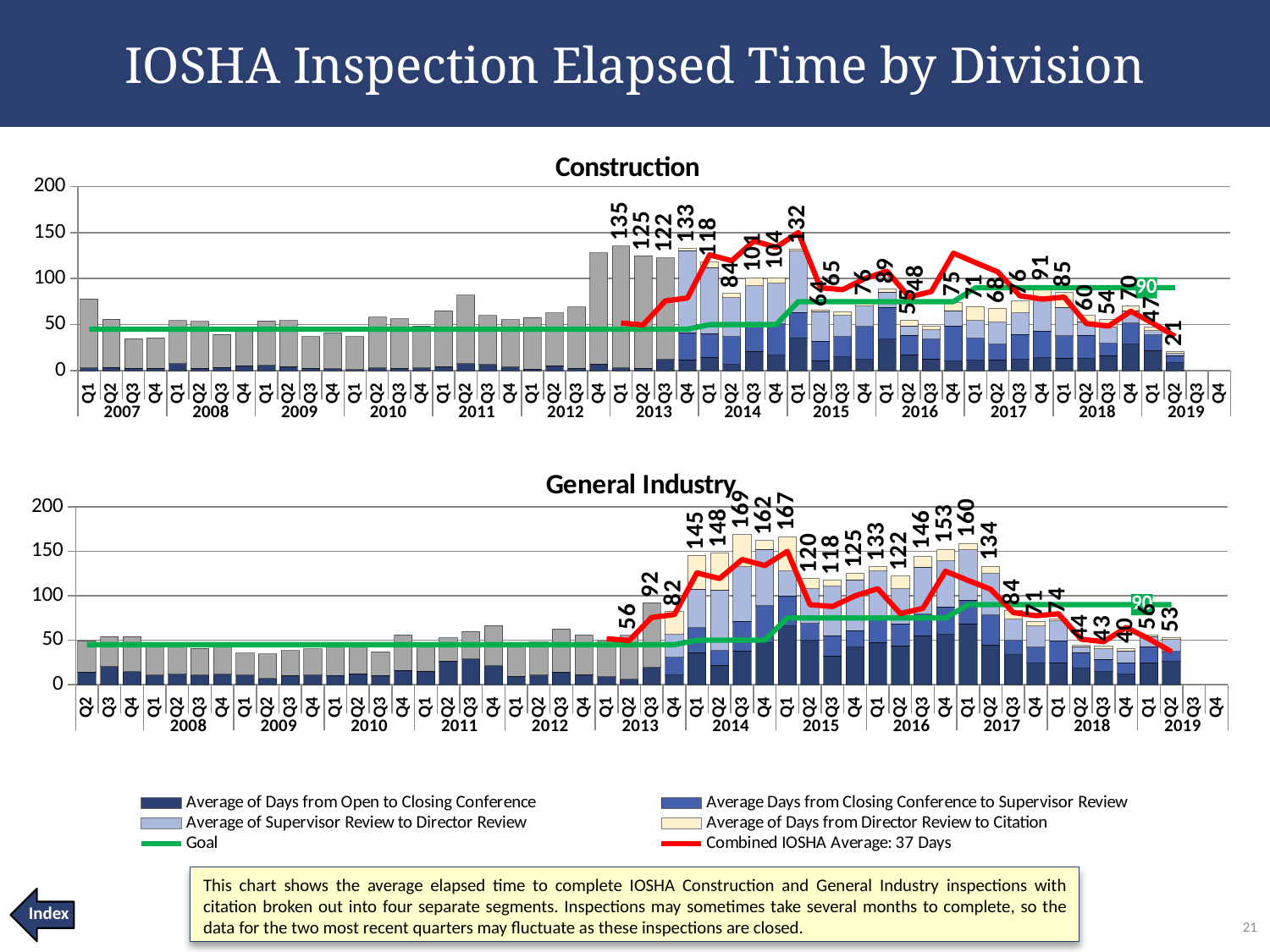
What value is the Goal line labeled with on both charts? 90 According to the legend, what is the Combined IOSHA Average? 37 Days In the General Industry chart, which quarter has the highest labeled total? Q3 2014 In the General Industry chart, which is larger: the labeled total for Q1 2014 or for Q2 2015? Q1 2014 In the Construction chart, is the total for Q4 2012 greater or less than 100? greater What kind of chart is the Construction chart? combination stacked bar and line chart In the General Industry chart, what is the labeled total for Q2 2019? 53 How many entries does the shared legend list? 6 In the Construction chart, which quarter has the highest labeled total? Q1 2013 In the Construction chart, what is the labeled total for Q2 2019? 21 In the Construction chart, what is the difference between the labeled totals for Q1 2013 and Q2 2019? 114 In the General Industry chart, do the labeled totals rise or fall from Q1 2017 to Q4 2017? fall